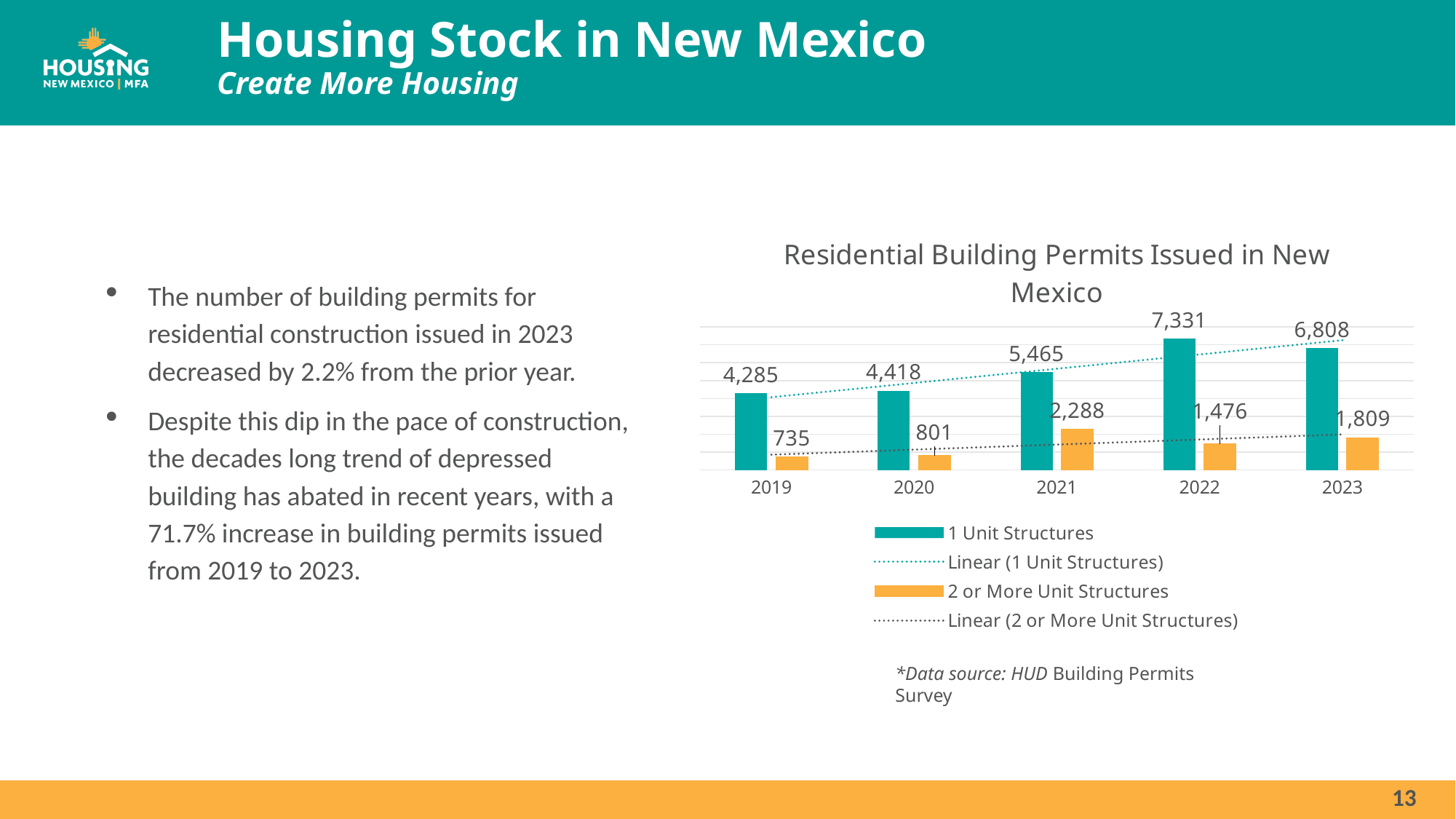
Which year has the highest value for 1 Unit Structures? 2022 What is the title of the chart? Residential Building Permits Issued in New Mexico Do the 1 Unit Structures values rise or fall from 2019 to 2022? Rise Which is larger, the 2 or More Unit Structures value for 2022 or for 2023? 2023 What kind of chart is shown on the slide? Bar chart Which year has the lowest value for 2 or More Unit Structures? 2019 How many entries does the legend list? 4 What is the difference between the 1 Unit Structures values for 2022 and 2023? 523 What is the value for 2 or More Unit Structures in 2019? 735 How many years are shown on the x axis? 5 What is the value for 2 or More Unit Structures in 2021? 2,288 What is the value for 1 Unit Structures in 2022? 7,331